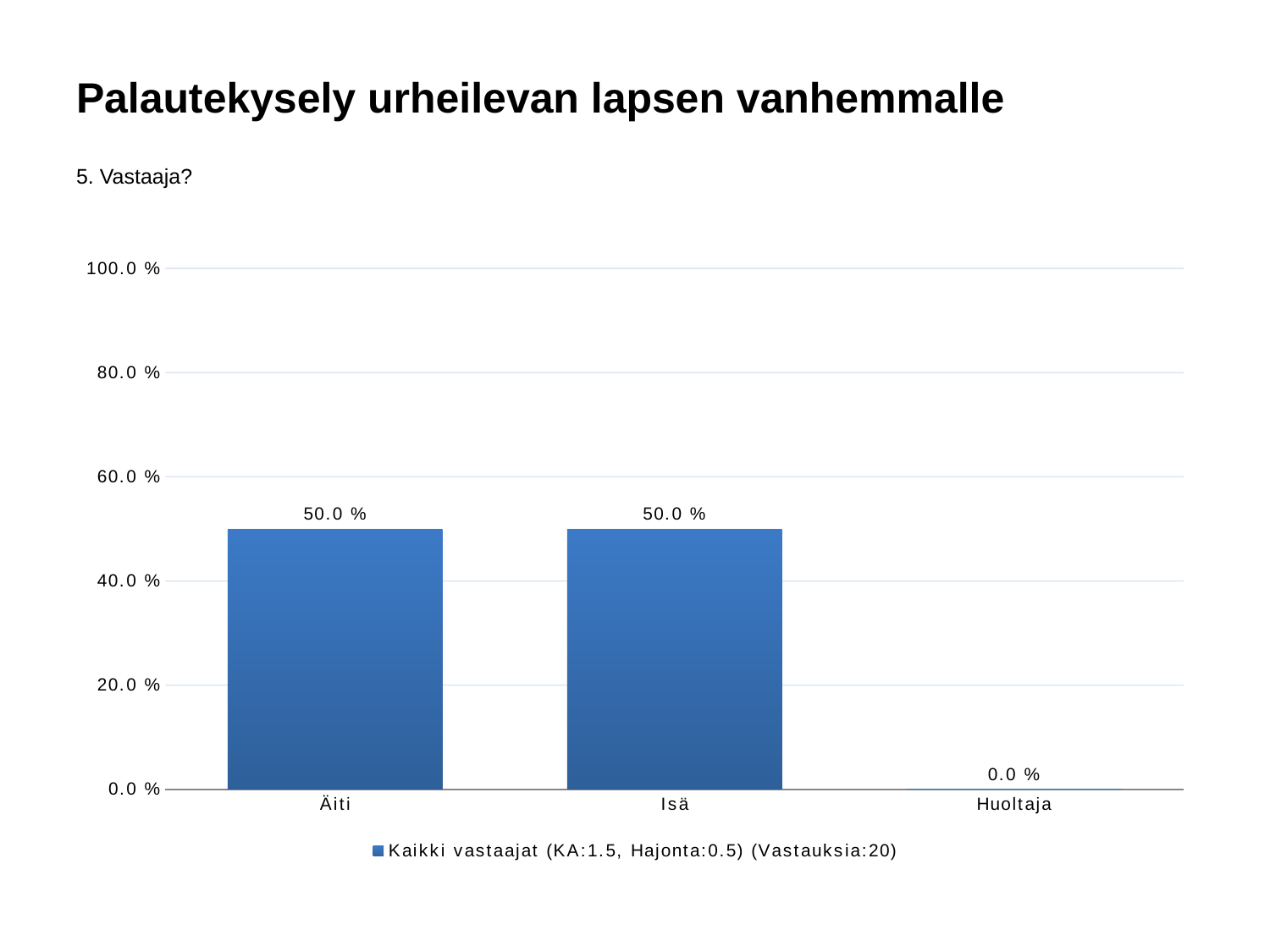
What is the question text shown above the chart? 5. Vastaaja? How many series does the legend list? 1 What is the difference between the values for Äiti and Huoltaja? 50.0 % What is the value for Huoltaja? 0.0 % How many categories are shown on the x axis? 3 What is the value for Äiti? 50.0 % Is the value for Äiti greater or less than 60.0 %? less Which is larger, the value for Isä or the value for Huoltaja? Isä What is the value for Isä? 50.0 % What kind of chart is shown on the slide? bar chart Which category has the lowest value? Huoltaja How many responses (Vastauksia) does the legend entry report? 20